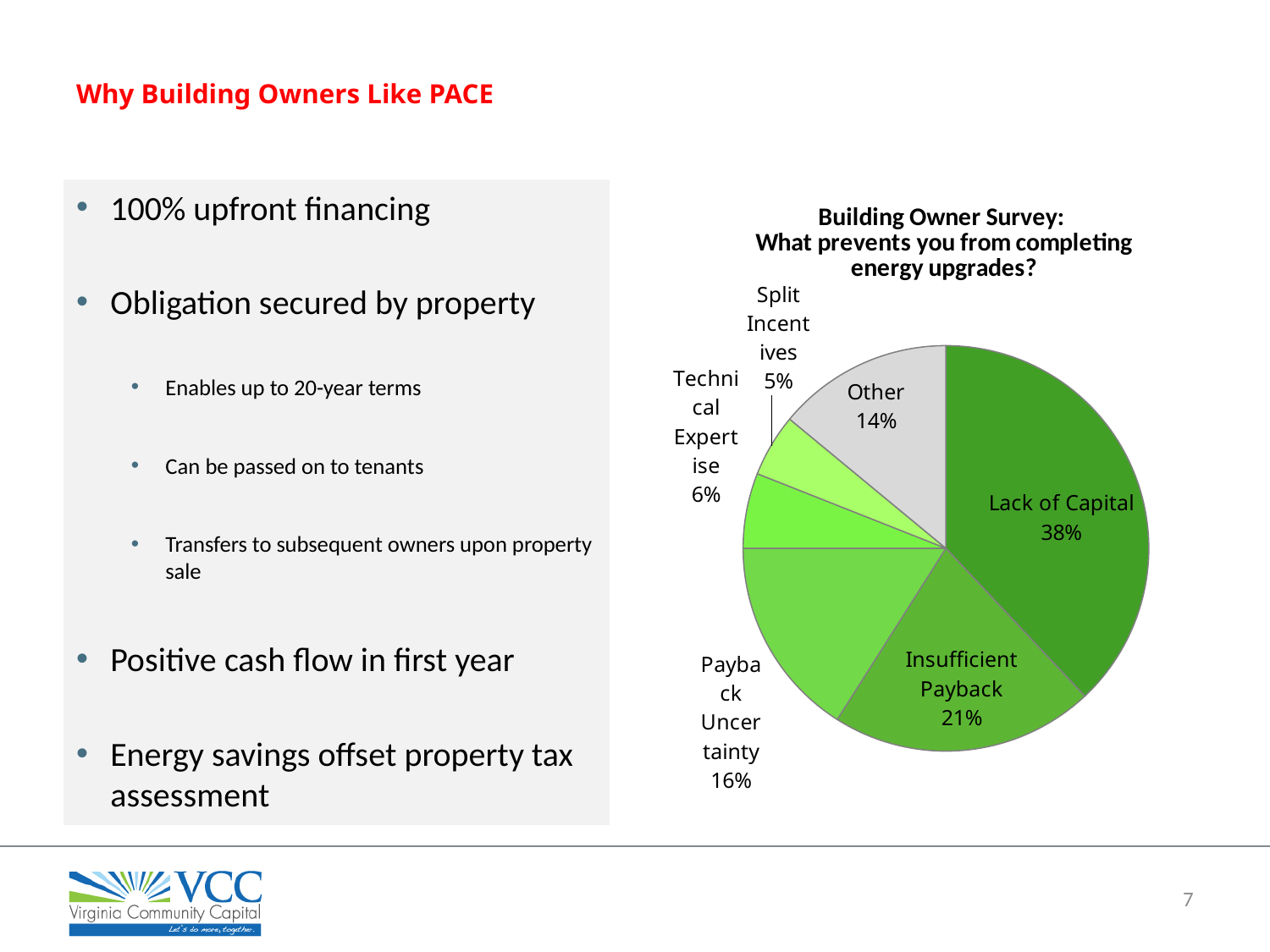
What percentage is shown for Technical Expertise? 6% What share of the pie is Lack of Capital? 38% What percentage is shown for Payback Uncertainty? 16% What percentage is shown for Other? 14% What percentage is shown for Insufficient Payback? 21% How many slices does the pie chart have? 6 What kind of chart is shown on the slide? pie chart What is the difference in percentage points between Lack of Capital and Insufficient Payback? 17 Which slice of the pie is the smallest? Split Incentives Which slice of the pie is the largest? Lack of Capital What is the title of the chart? Building Owner Survey: What prevents you from completing energy upgrades? What percentage is shown for Split Incentives? 5%